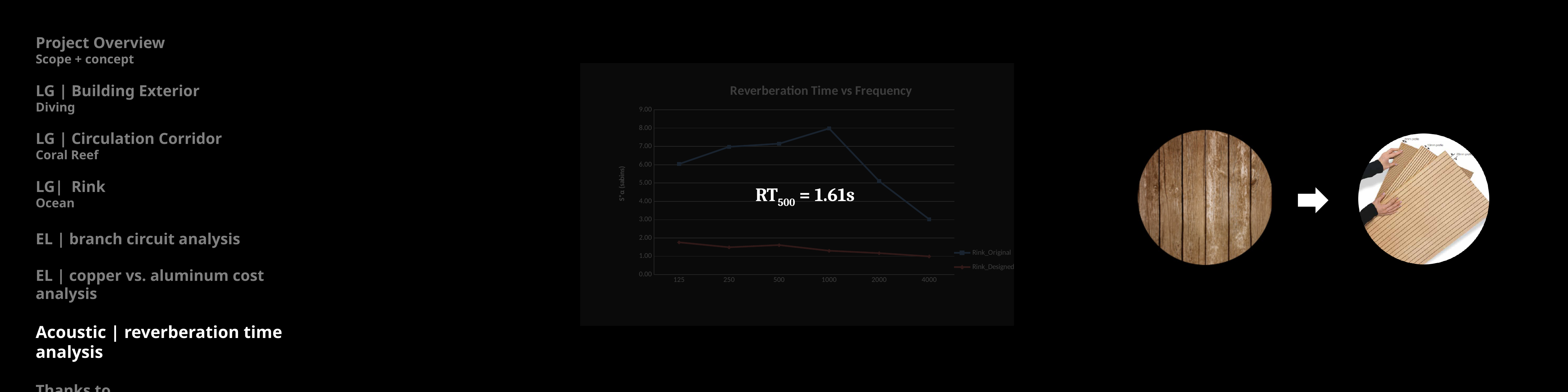
What kind of chart is shown on the slide? line chart What are the two series named in the chart legend? Rink_Original and Rink_Designed What is the title of the chart? Reverberation Time vs Frequency How many series does the chart legend list? 2 Is the value for Rink_Original at 4000 greater or less than 4.00? less At which frequency does the Rink_Designed series reach its lowest value? 4000 At 500, which series has the larger value, Rink_Original or Rink_Designed? Rink_Original How many frequency points are plotted along the x axis? 6 Is the value for Rink_Original at 1000 greater or less than 7.00? greater At which frequency does the Rink_Original series reach its lowest value? 4000 At which frequency does the Rink_Original series reach its highest value? 1000 Is the value for Rink_Designed at 125 greater or less than 2.00? less